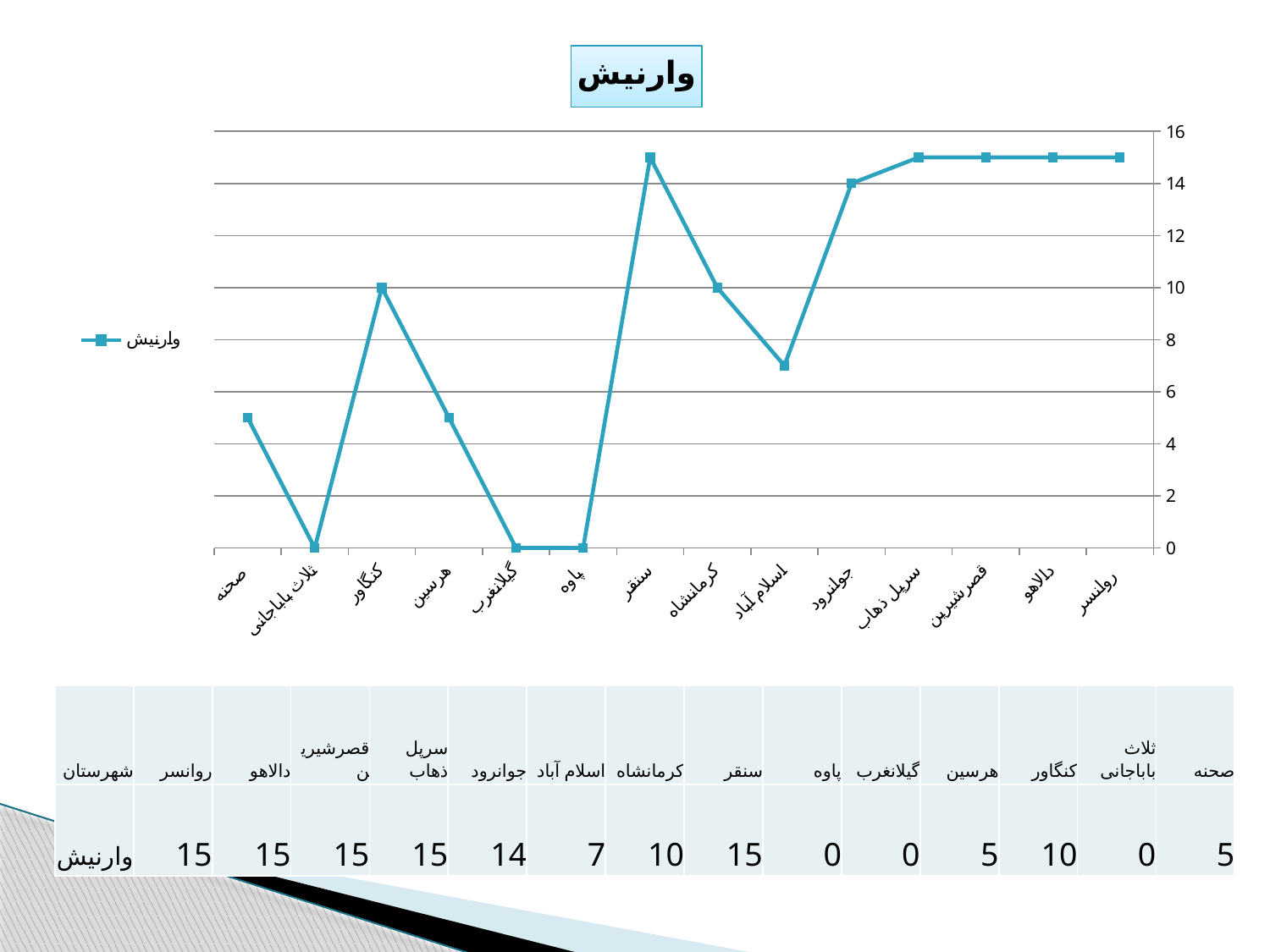
What is the value for کرمانشاه? 10 What is the value for اسلام آباد? 7 What is the difference between the values for کنگاور and گیلانغرب? 10 What is the difference between the values for سنقر and اسلام آباد? 8 Is the value for جوانرود greater or less than 10? greater What type of chart is shown on the slide? line chart What is the value for هرسین? 5 How many series does the legend list? 1 What is the title of the chart? وارنیش How many categories are plotted on the x axis? 14 What is the value for جوانرود? 14 Which value is larger, کنگاور or صحنه? کنگاور